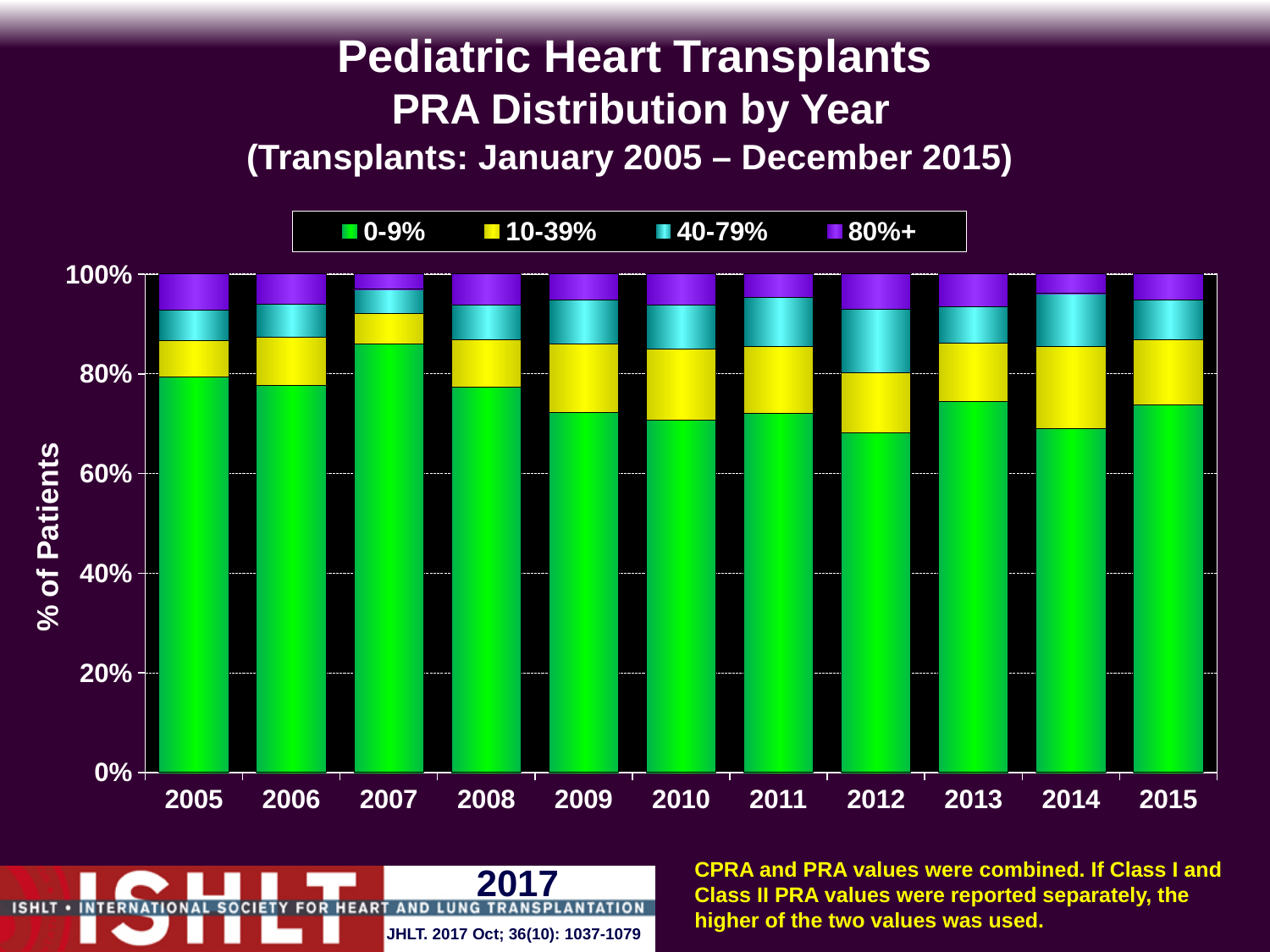
Which year has the largest 0-9% segment? 2007 How many series does the legend list? 4 Which legend entry is shown in purple? 80%+ Which year has a larger 0-9% segment, 2007 or 2012? 2007 How many years are shown along the x axis of the chart? 11 What is the label of the y axis? % of Patients What is the total height of each stacked bar in the chart? 100% Is the 0-9% value for 2012 greater or less than 80%? less Is the 0-9% value for 2009 greater or less than 80%? less Is the 0-9% value for 2010 greater or less than 60%? greater What kind of chart is shown on the slide? Stacked bar chart